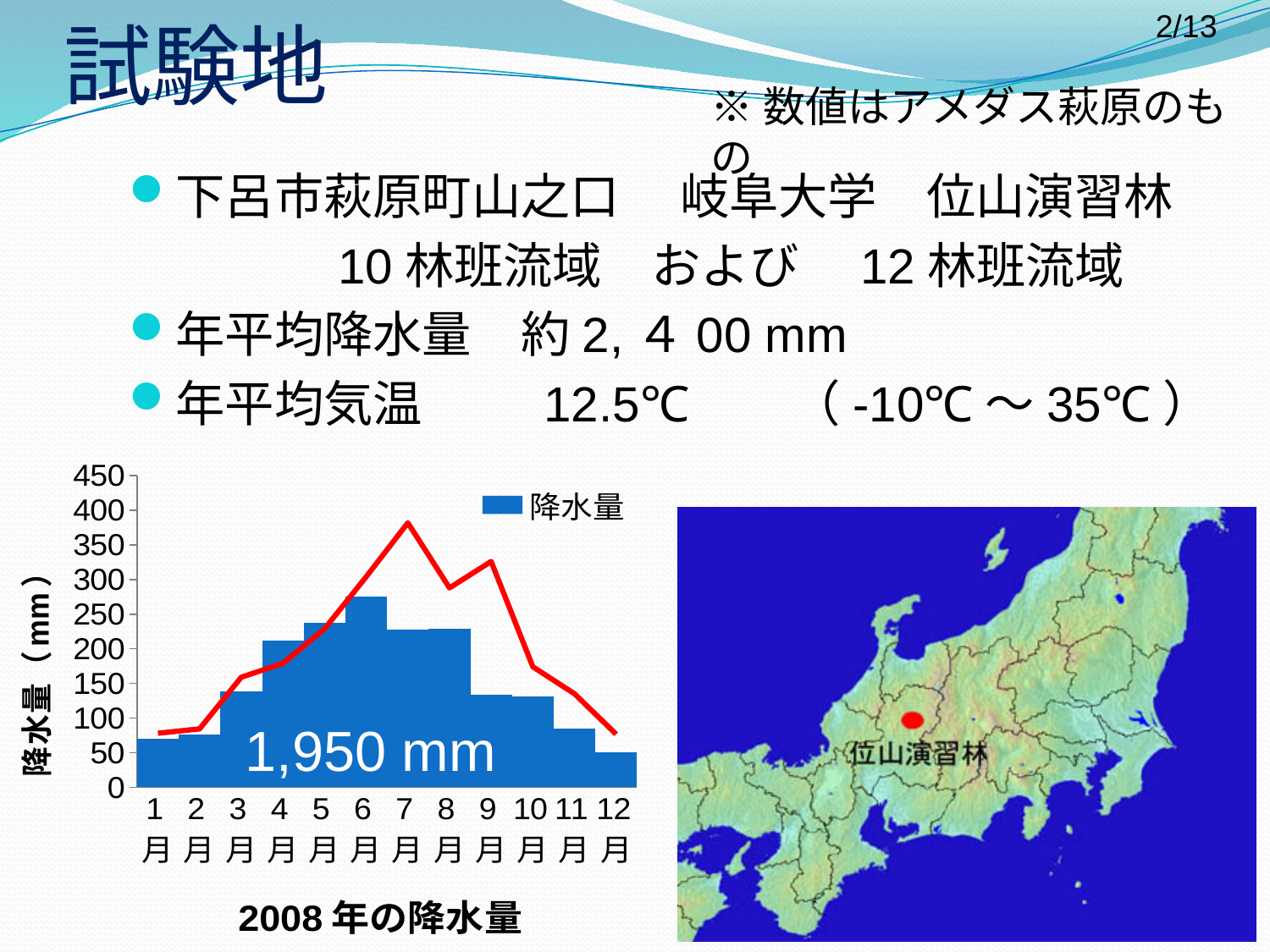
How many months (categories) are shown on the x axis of the precipitation chart? 12 Is the precipitation bar for 6月 greater or less than 250? greater Which month has the lowest precipitation bar in the 2008 chart? 12月 What is the label on the y axis of the precipitation chart? 降水量（mm） Which month has the larger precipitation bar, 3月 or 11月? 3月 Is the precipitation bar for 11月 greater or less than 100? less Do the precipitation bars rise or fall from 6月 to 12月? fall How many series does the legend of the precipitation chart list? 1 Which month has the highest precipitation bar in the 2008 chart? 6月 What annual total is printed inside the precipitation chart? 1,950 mm Is the precipitation bar for 7月 greater or less than 250? less What kind of chart is used to show the 2008 monthly precipitation? bar chart